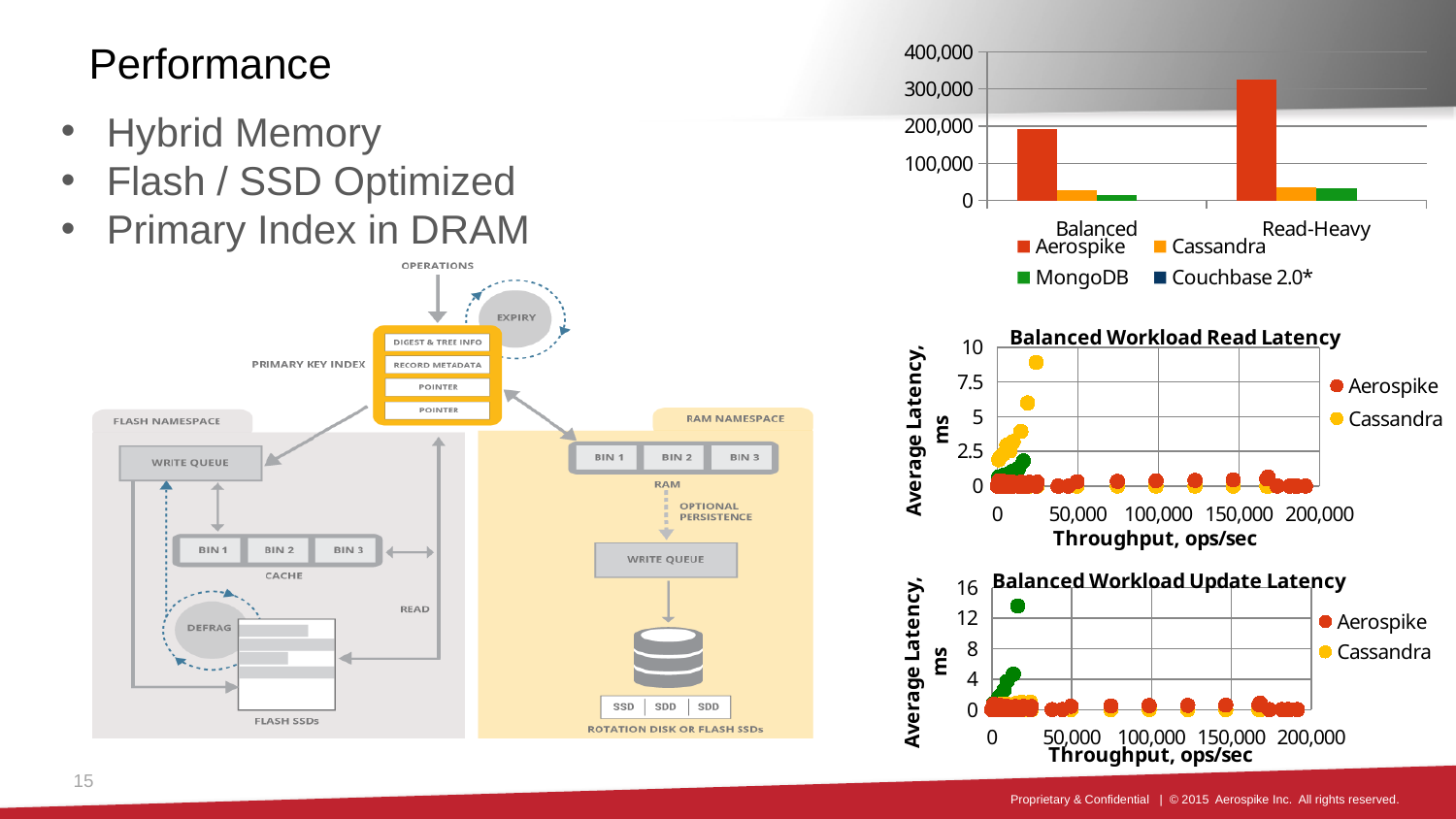
In the top-right bar chart, is the Aerospike value larger for Balanced or for Read-Heavy? Read-Heavy In the top-right bar chart, is the Cassandra value for Balanced greater or less than 100,000? less What is the title of the middle chart on the right side of the slide? Balanced Workload Read Latency In the top-right bar chart, how many categories are shown on the x axis? 2 In the top-right bar chart, which series has the highest value for the Balanced category? Aerospike In the top-right bar chart, is the Aerospike value for Read-Heavy greater or less than 200,000? greater In the Balanced Workload Update Latency chart, how many series does the legend list? 2 In the top-right bar chart, how many series does the legend list? 4 What kind of chart is the top-right chart with the Balanced and Read-Heavy categories? bar chart In the Balanced Workload Read Latency chart, which series has the highest plotted latency value? Cassandra In the top-right bar chart, what is the highest value shown on the vertical axis? 400,000 In the top-right bar chart, which series has the highest value for the Read-Heavy category? Aerospike